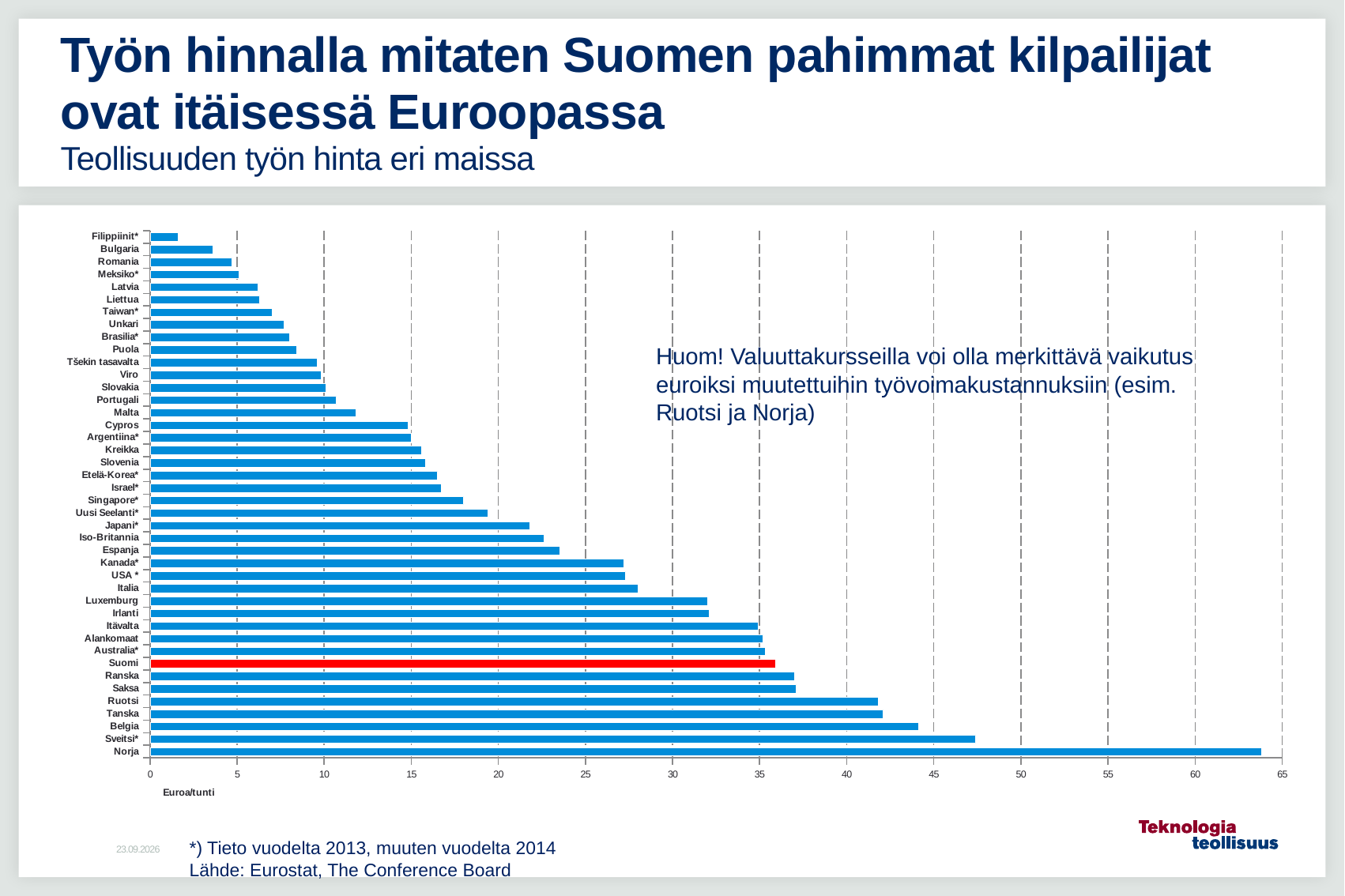
Which country has the lowest value in the chart? Filippiinit* What kind of chart is shown on the slide? bar chart Which bar is highlighted in red in the chart? Suomi How many countries are listed in the chart? 42 What unit is shown on the x axis of the chart? Euroa/tunti Is the value for Norja greater or less than 60? greater Is the value for Suomi greater or less than 40? less Is the value for Belgia greater or less than 40? greater Which has the larger value, Italia or Espanja? Italia Which country has the highest value in the chart? Norja